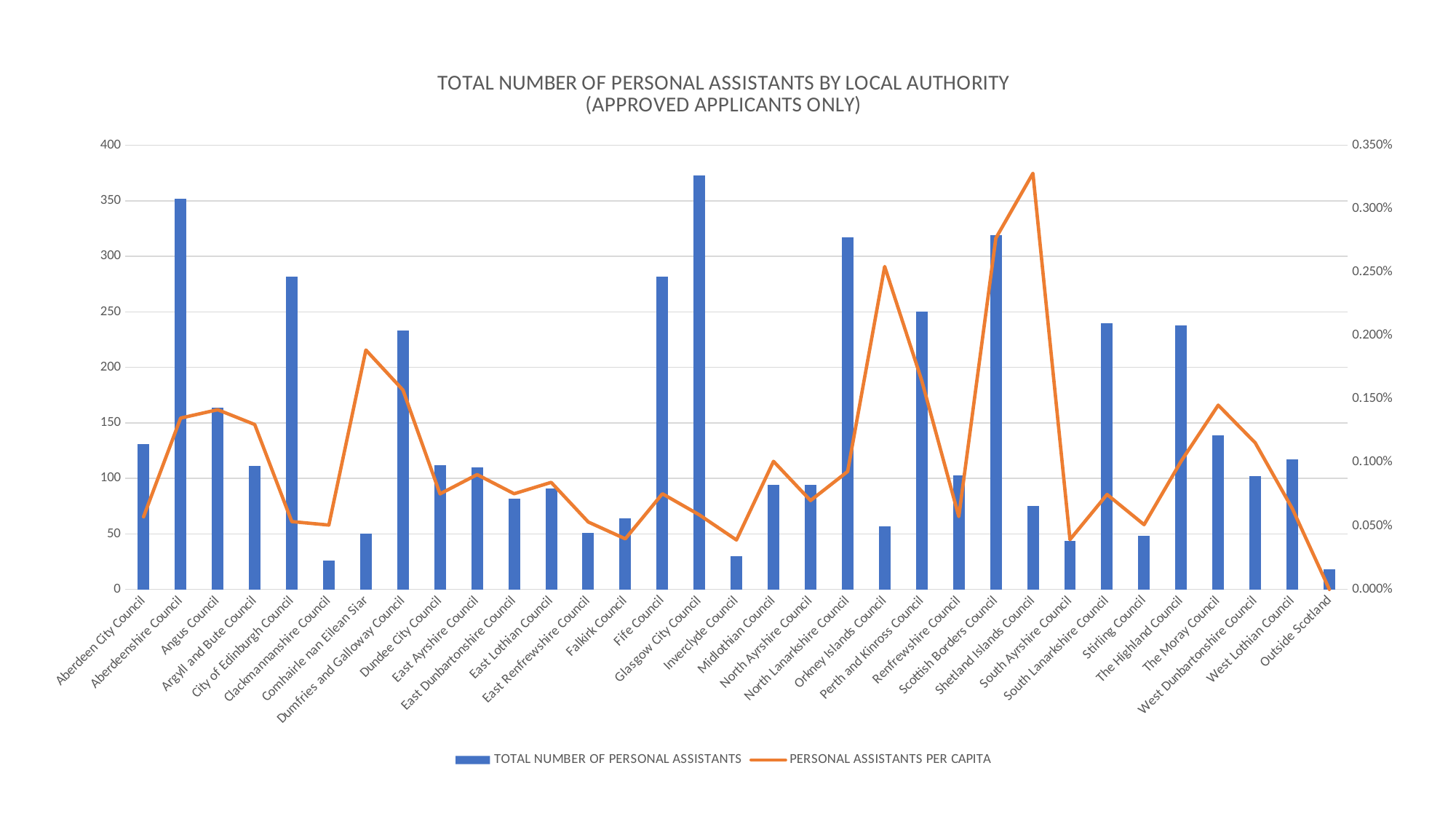
Which local authority has the highest personal assistants per capita? Shetland Islands Council Is the personal assistants per capita value for Orkney Islands Council greater or less than 0.200%? greater Is the total number of personal assistants for Aberdeenshire Council greater or less than 300? greater What colour is the line for personal assistants per capita? Orange Is the total number of personal assistants for Dumfries and Galloway Council greater or less than 200? greater What kind of chart is shown on the slide? Combined bar and line chart Which has more total personal assistants, Aberdeenshire Council or Scottish Borders Council? Aberdeenshire Council Which category has the lowest total number of personal assistants? Outside Scotland How many local authority categories are shown on the x axis? 33 How many series does the legend list? 2 Which local authority has the highest total number of personal assistants? Glasgow City Council